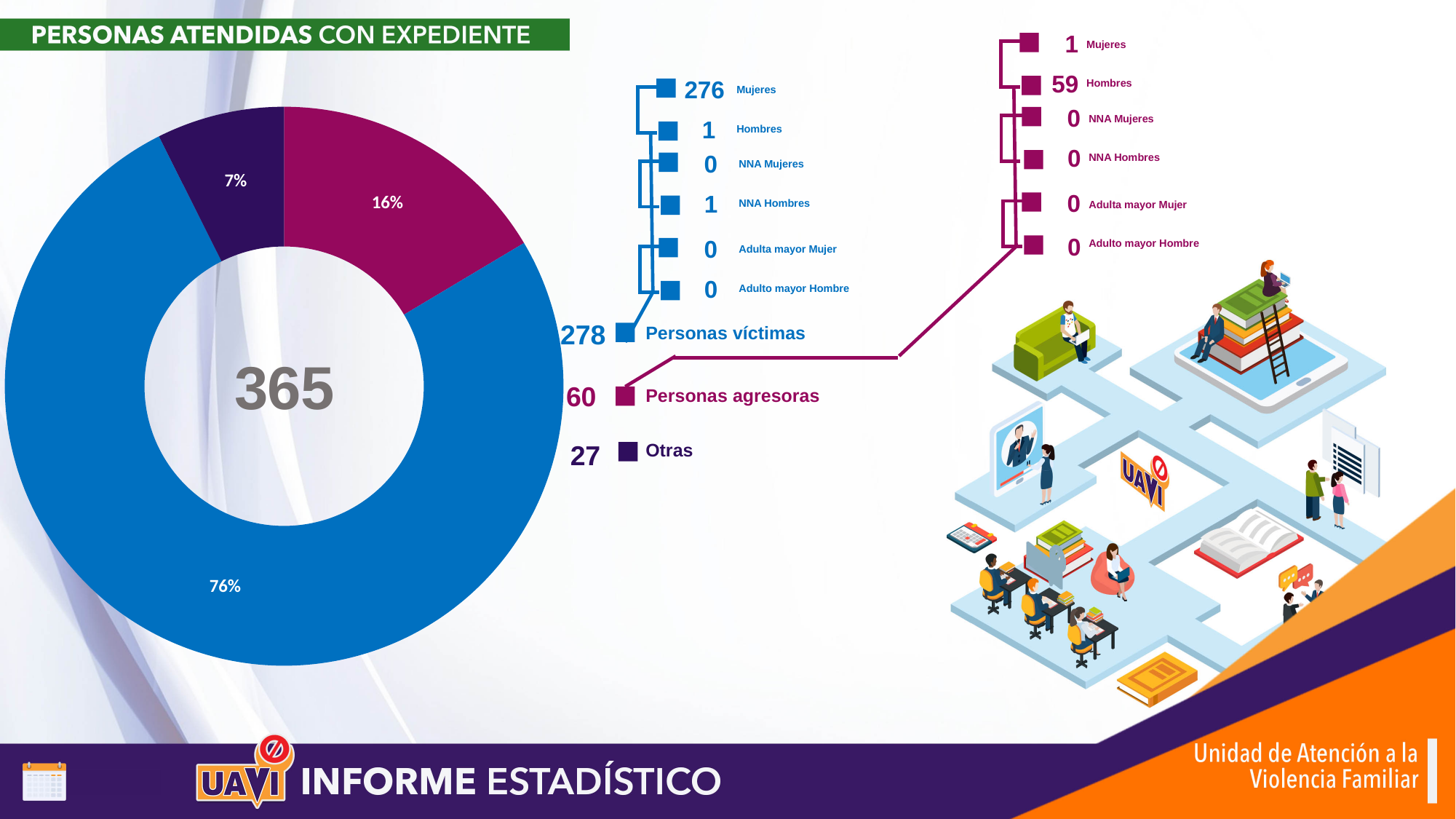
What percentage of the donut chart corresponds to Personas agresoras? 16% How many slices does the donut chart have? 3 What is the total number shown in the centre of the donut chart? 365 Which category has the largest slice of the donut chart? Personas víctimas What percentage of the donut chart corresponds to Personas víctimas? 76% What is the difference between the number of Personas víctimas and Personas agresoras? 218 Which category has the smallest slice of the donut chart? Otras What kind of chart is shown on the slide? Donut (pie) chart How many Personas agresoras are reported? 60 What percentage of the donut chart corresponds to Otras? 7% How many Personas víctimas are reported? 278 Which is larger, the number of Personas agresoras or the number of Otras? Personas agresoras